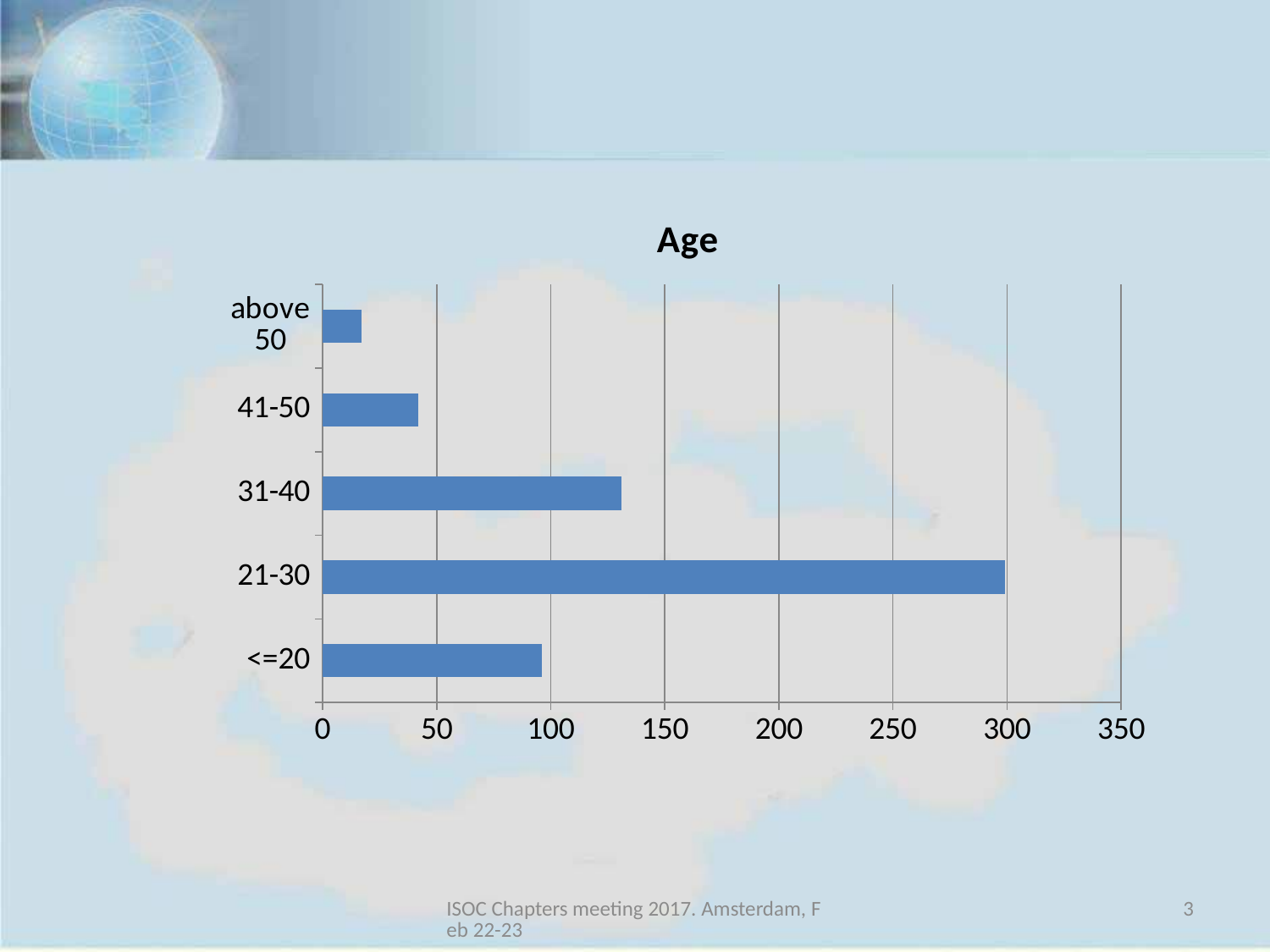
What kind of chart is shown on the slide? bar chart Which age category has the lowest value? above 50 Which has a larger value, 31-40 or <=20? 31-40 Is the value for 21-30 greater or less than 250? greater Is the value for 41-50 greater or less than 50? less Which age category has the highest value? 21-30 Is the value for above 50 greater or less than 50? less Which has a larger value, 41-50 or above 50? 41-50 How many age categories are shown in the chart? 5 What is the title of the chart? Age